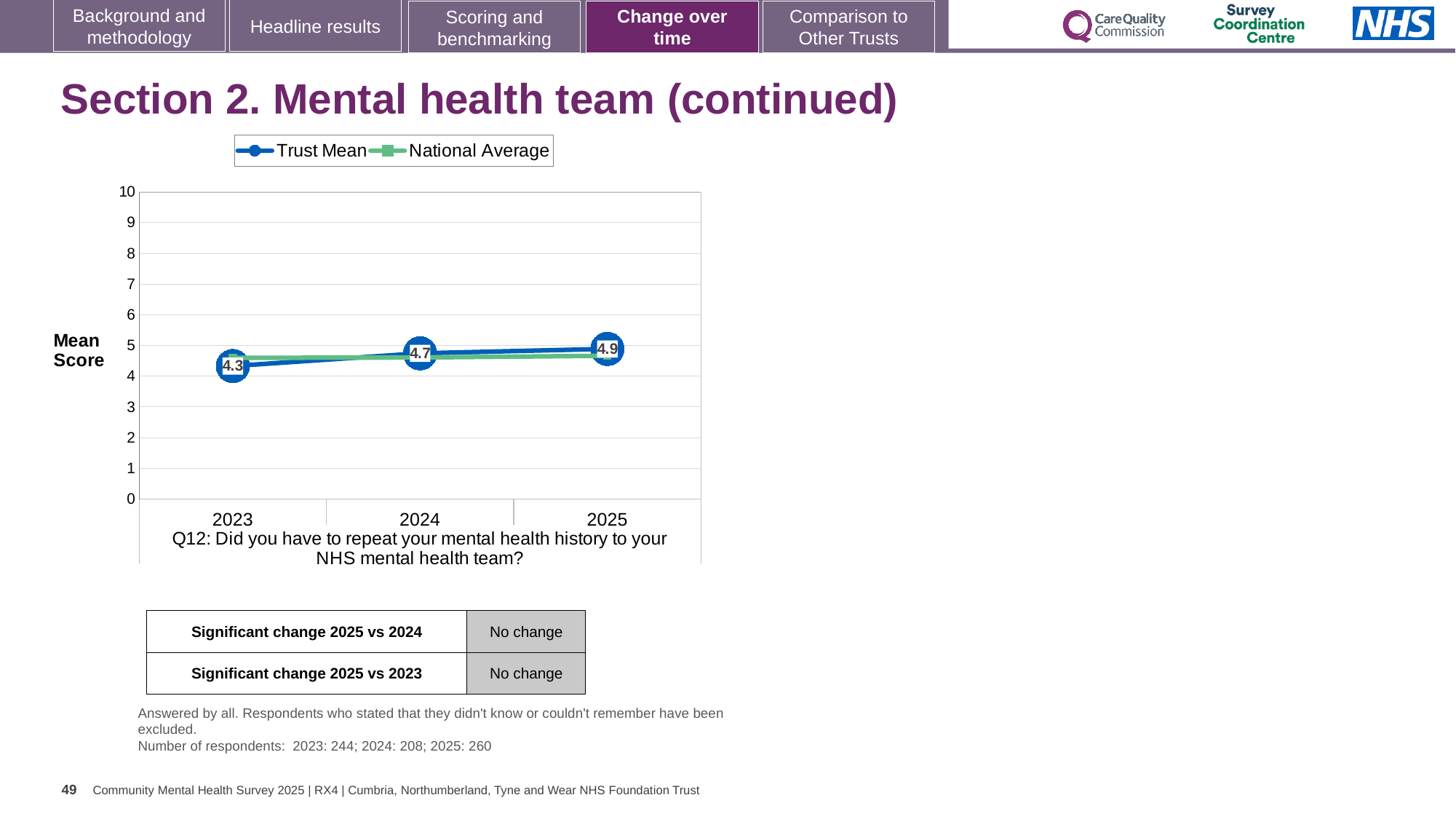
In which year is the Trust Mean score highest? 2025 Is the National Average value for 2025 greater or less than 5? less How many series does the legend list? 2 Which year has the larger Trust Mean score, 2024 or 2025? 2025 What is the Trust Mean score for 2025? 4.9 What kind of chart is shown on the slide? line chart Does the Trust Mean score rise or fall from 2023 to 2025? rise What is the Trust Mean score for 2023? 4.3 How many years are plotted on the x axis? 3 In which year is the Trust Mean score lowest? 2023 What is the Trust Mean score for 2024? 4.7 By how much did the Trust Mean score increase from 2023 to 2025? 0.6